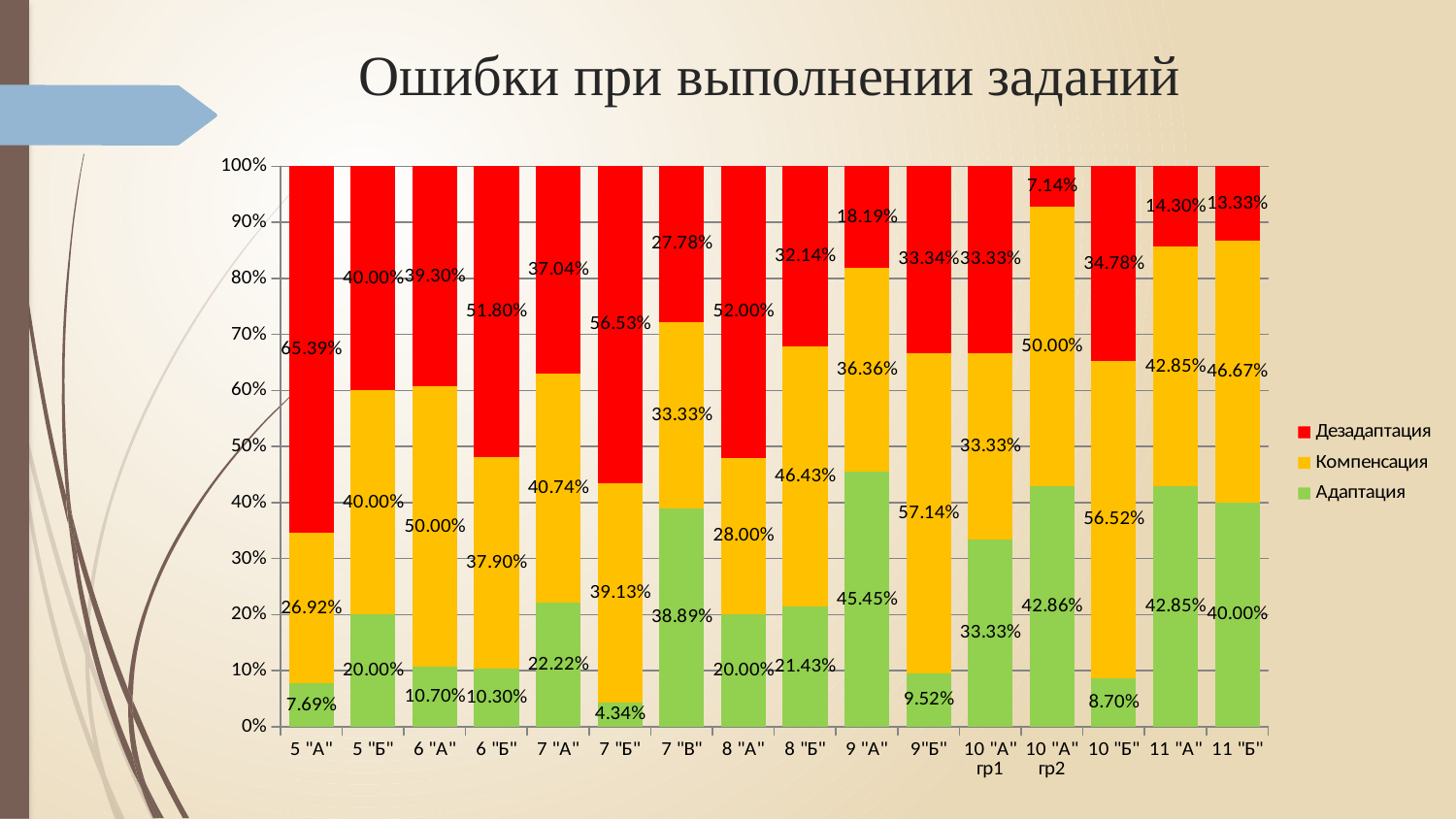
Which category has the lowest Дезадаптация value? 10 "А" гр2 How many series does the legend list? 3 What is the Дезадаптация value for 7 "Б"? 56.53% What is the title of the chart? Ошибки при выполнении заданий What is the Адаптация value for 5 "А"? 7.69% What kind of chart is shown on the slide? Stacked bar chart Which is larger: the Адаптация value for 9 "А" or for 11 "Б"? 9 "А" Which category has the highest Дезадаптация value? 5 "А" What is the Компенсация value for 10 "Б"? 56.52% Which category has the lowest Адаптация value? 7 "Б" How many categories are shown on the x axis? 16 What is the difference between the Дезадаптация and Адаптация values for 5 "А"? 57.70%